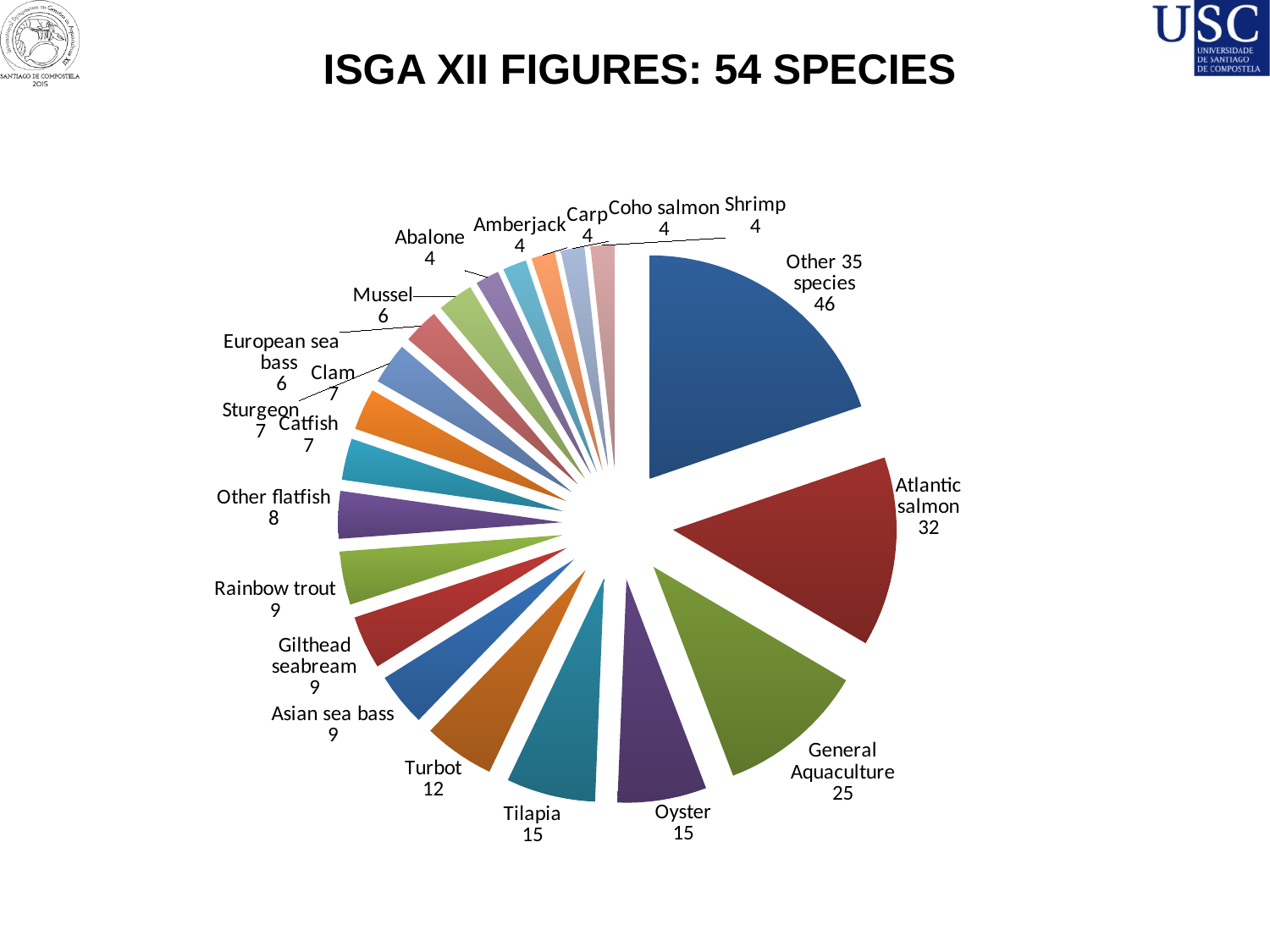
What kind of chart is shown on the slide? Pie chart Which category has the largest slice? Other 35 species What is the value for Other flatfish? 8 What is the value for Atlantic salmon? 32 What is the value for General Aquaculture? 25 Which is larger, the value for General Aquaculture or the value for Oyster? General Aquaculture What is the title of the slide? ISGA XII FIGURES: 54 SPECIES What is the difference between the values for Other 35 species and Atlantic salmon? 14 What is the difference between the values for Tilapia and Turbot? 3 How many slices does the pie chart have? 20 Which is larger, the value for Rainbow trout or the value for Mussel? Rainbow trout What is the value for Turbot? 12